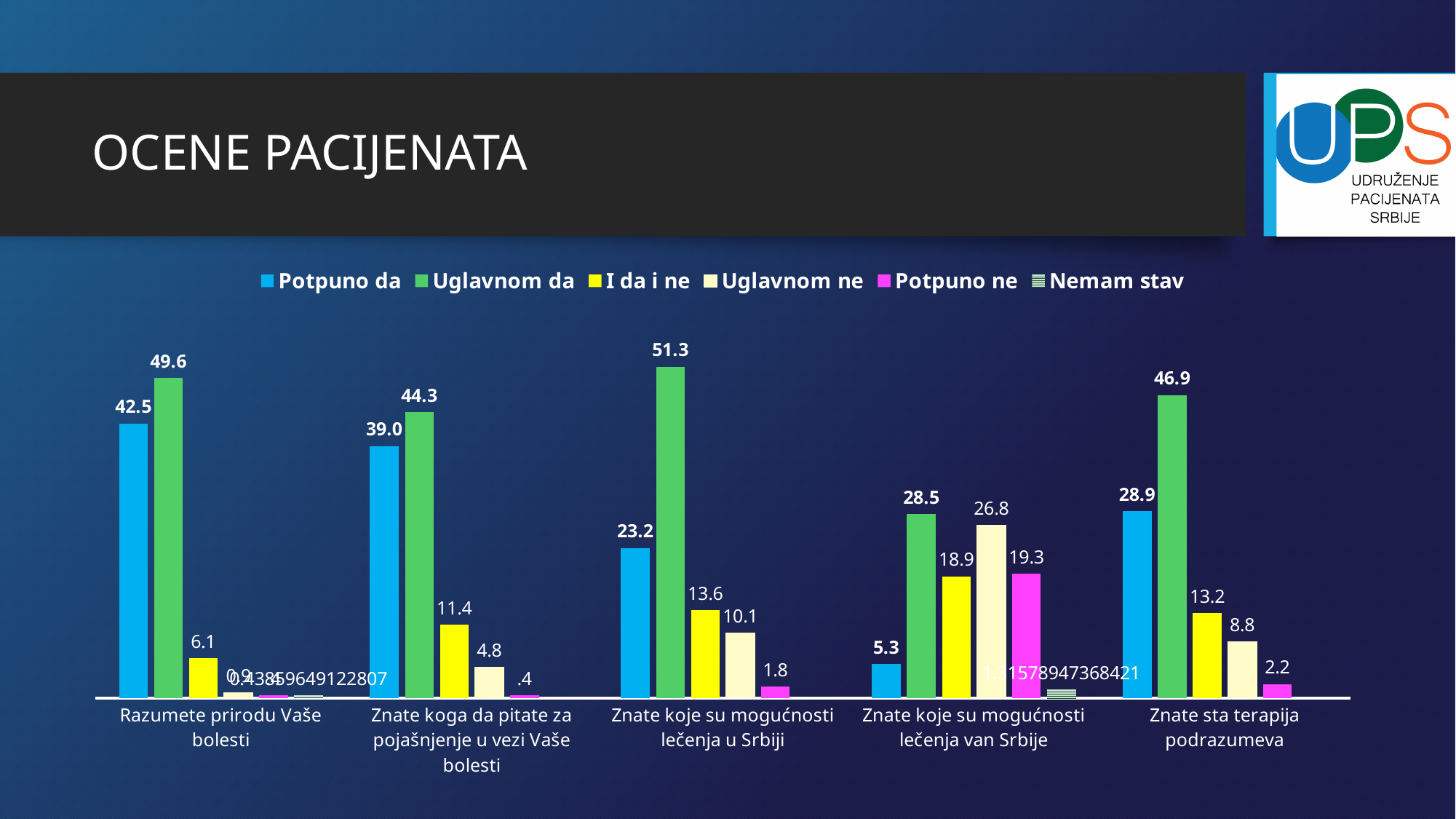
What is the title of the slide containing the chart? OCENE PACIJENATA What is the value of 'Uglavnom ne' for 'Znate koje su mogućnosti lečenja van Srbije'? 26.8 Which category has the highest 'Uglavnom da' value? Znate koje su mogućnosti lečenja u Srbiji For 'Znate koje su mogućnosti lečenja van Srbije', which is larger: 'I da i ne' or 'Potpuno ne'? Potpuno ne How many question categories are shown along the x axis? 5 What is the value of 'Potpuno ne' for 'Znate sta terapija podrazumeva'? 2.2 Which category has the lowest 'Potpuno da' value? Znate koje su mogućnosti lečenja van Srbije What type of chart is shown on the slide? bar chart What is the value of 'Uglavnom da' for 'Znate koje su mogućnosti lečenja u Srbiji'? 51.3 What is the difference between 'Uglavnom da' and 'Potpuno da' for 'Znate sta terapija podrazumeva'? 18.0 How many series does the legend list? 6 What is the value of 'Potpuno da' for 'Razumete prirodu Vaše bolesti'? 42.5